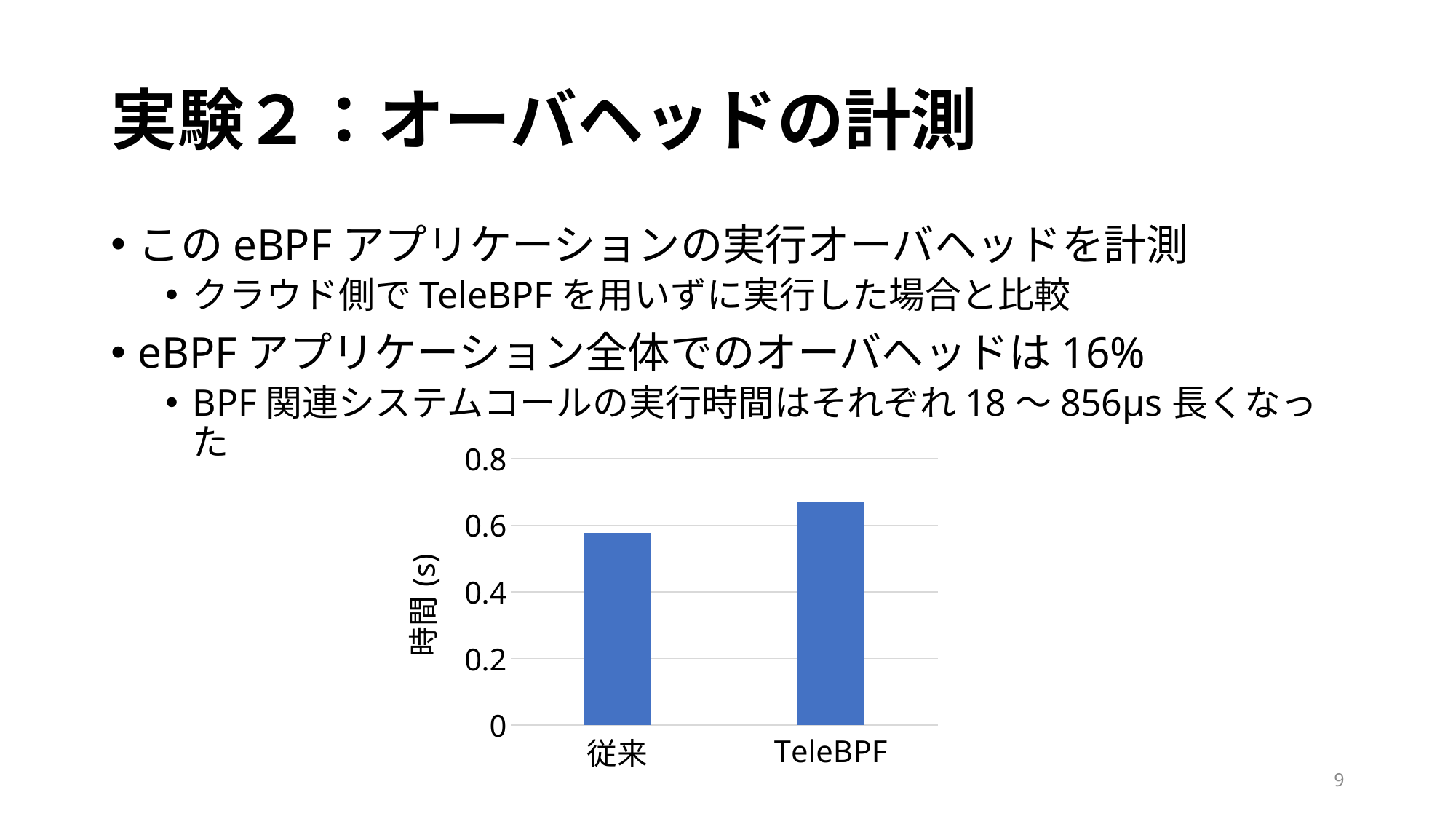
What is the label of the vertical axis of the chart? 時間 (s) Which category has the lowest value in the chart? 従来 What is the highest tick value shown on the vertical axis? 0.8 Which is larger, the value for 従来 or the value for TeleBPF? TeleBPF Do the values rise or fall from 従来 to TeleBPF along the x axis? rise Which category has the highest value in the chart? TeleBPF Is the value for 従来 greater or less than 0.6? less Is the value for 従来 greater or less than 0.4? greater Is the value for TeleBPF greater or less than 0.6? greater How many bars (categories) does the chart show? 2 What kind of chart is shown on the slide? bar chart